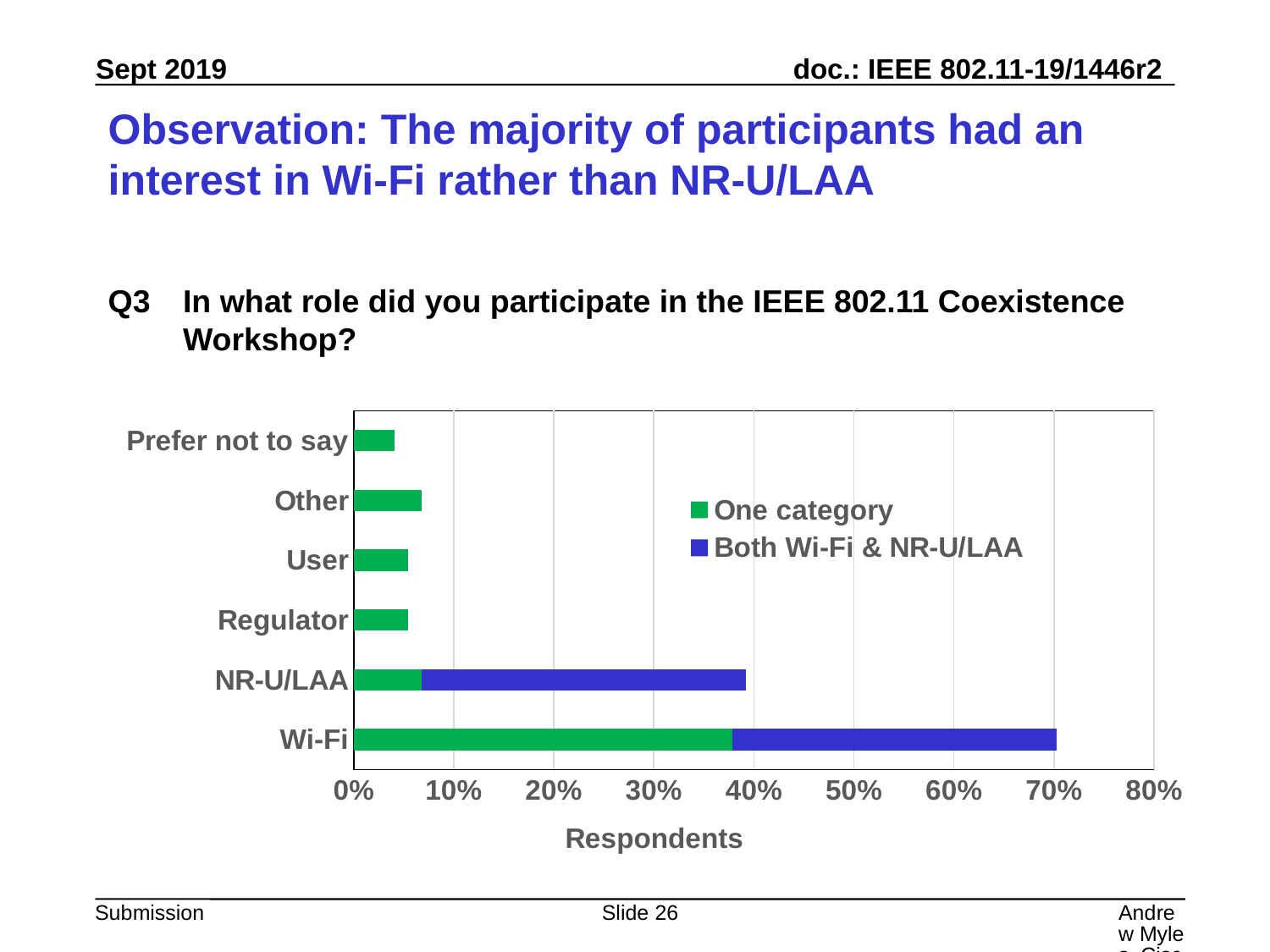
Is the total bar for NR-U/LAA greater or less than 50%? less How many series does the chart's legend list? 2 What kind of chart is shown on the slide? bar chart Is the total bar for Wi-Fi greater or less than 60%? greater Is the total bar for NR-U/LAA greater or less than 30%? greater Which has a longer total bar, Wi-Fi or NR-U/LAA? Wi-Fi Which category has the shortest bar in the chart? Prefer not to say What is the title of the horizontal axis of the chart? Respondents How many categories are shown on the vertical axis of the chart? 6 Which category has the longest total bar in the chart? Wi-Fi Which series in the legend is shown in blue? Both Wi-Fi & NR-U/LAA